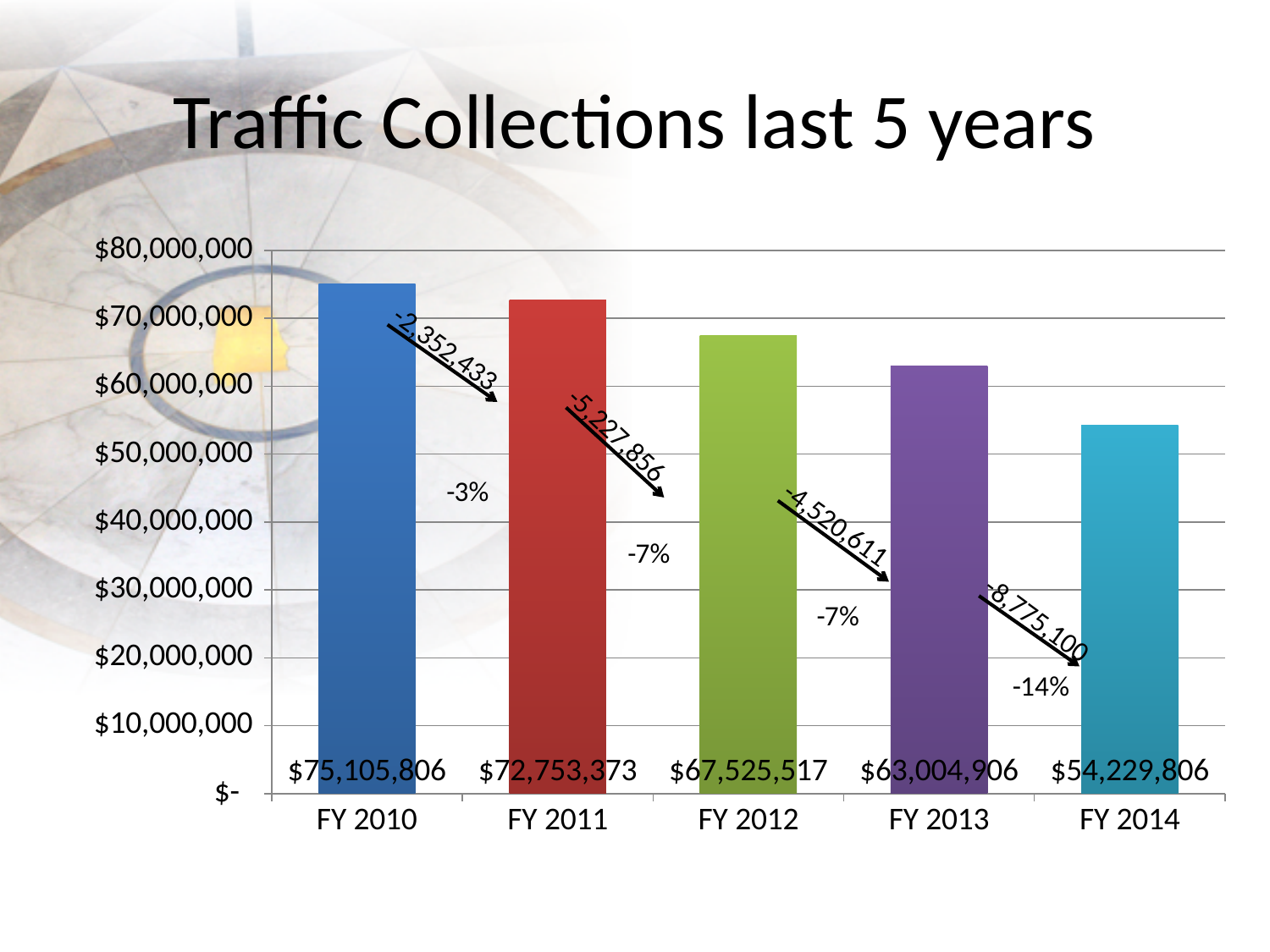
Which fiscal year has the highest traffic collections? FY 2010 What is the difference in traffic collections between FY 2013 and FY 2014? $8,775,100 What is the traffic collections value for FY 2012? $67,525,517 What is the traffic collections value for FY 2010? $75,105,806 Which is larger, the traffic collections for FY 2011 or FY 2013? FY 2011 What is the traffic collections value for FY 2014? $54,229,806 How many fiscal years are shown in the chart? 5 What kind of chart is shown on the slide? bar chart What is the difference in traffic collections between FY 2010 and FY 2014? $20,876,000 What is the difference in traffic collections between FY 2010 and FY 2011? $2,352,433 Is the value for FY 2013 greater or less than $60,000,000? greater Which fiscal year has the lowest traffic collections? FY 2014